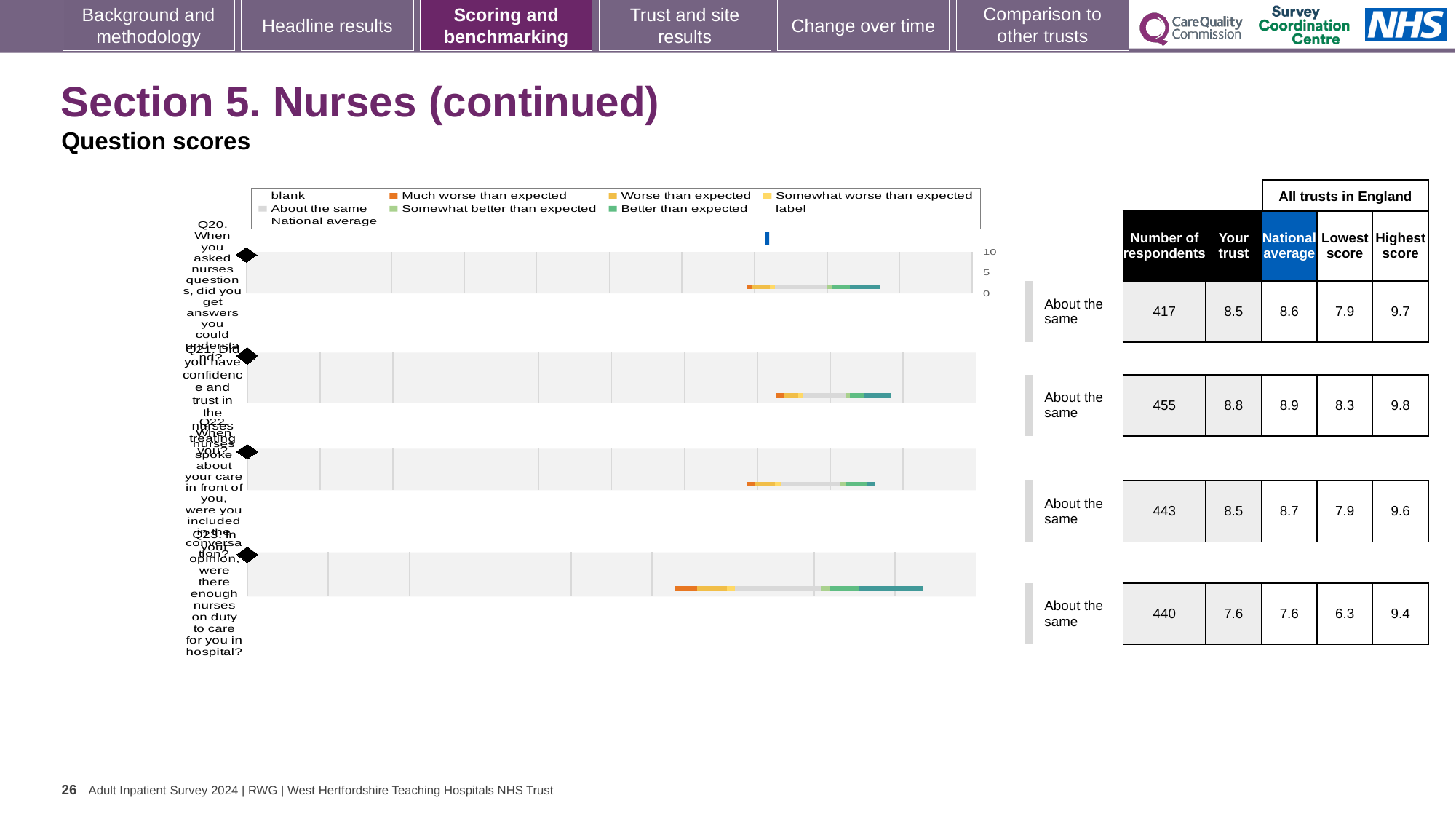
What is the lowest score among all trusts in England for Q23? 6.3 In the chart legend, which colour represents 'Better than expected'? teal What is the national average score for Q22? 8.7 What kind of chart is used to show the question scores on this slide? bar chart What is the 'Your trust' score for Q21? 8.8 In the chart legend, which colour represents 'Much worse than expected'? orange What is the number of respondents for Q20? 417 What is the difference between the highest score and the lowest score for Q23? 3.1 For Q20, which is larger: the 'Your trust' score or the national average? national average Which question has the lowest 'Your trust' score? Q23 Which question has the highest 'Your trust' score? Q21 How many questions (Q20 to Q23) have a bar chart on this slide? 4